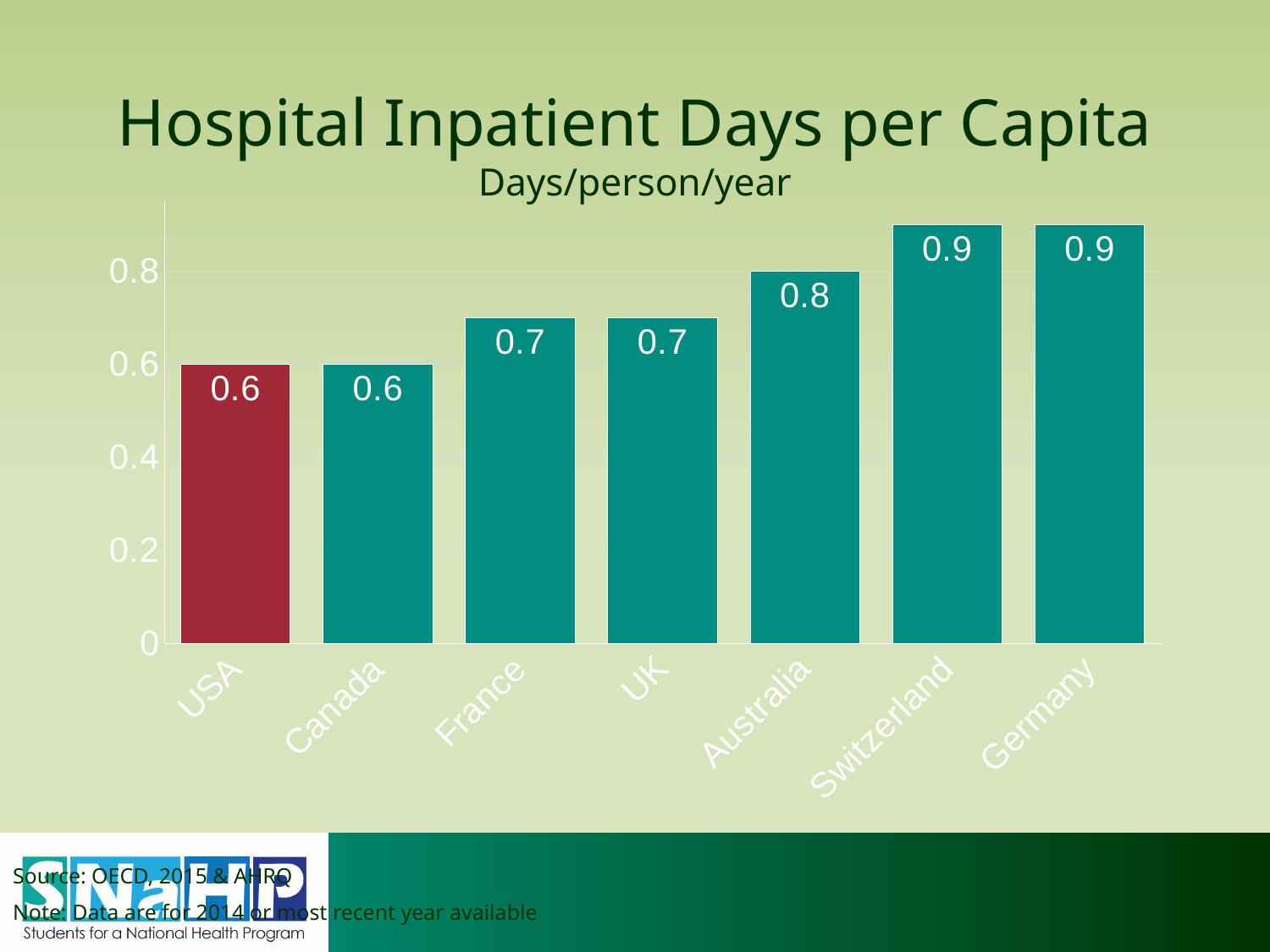
What is the difference between the values for Switzerland and the USA? 0.3 What is the lowest value shown on the chart? 0.6 What is the value for Australia? 0.8 What is the value for the USA? 0.6 What is the value for France? 0.7 What is the highest value shown on the chart? 0.9 Which country's bar is coloured differently from the others? USA Which has a larger value, Australia or Canada? Australia What is the value for Germany? 0.9 Do the values rise or fall moving from left to right along the x axis? Rise How many countries are shown on the chart? 7 What kind of chart is shown on the slide? Bar chart